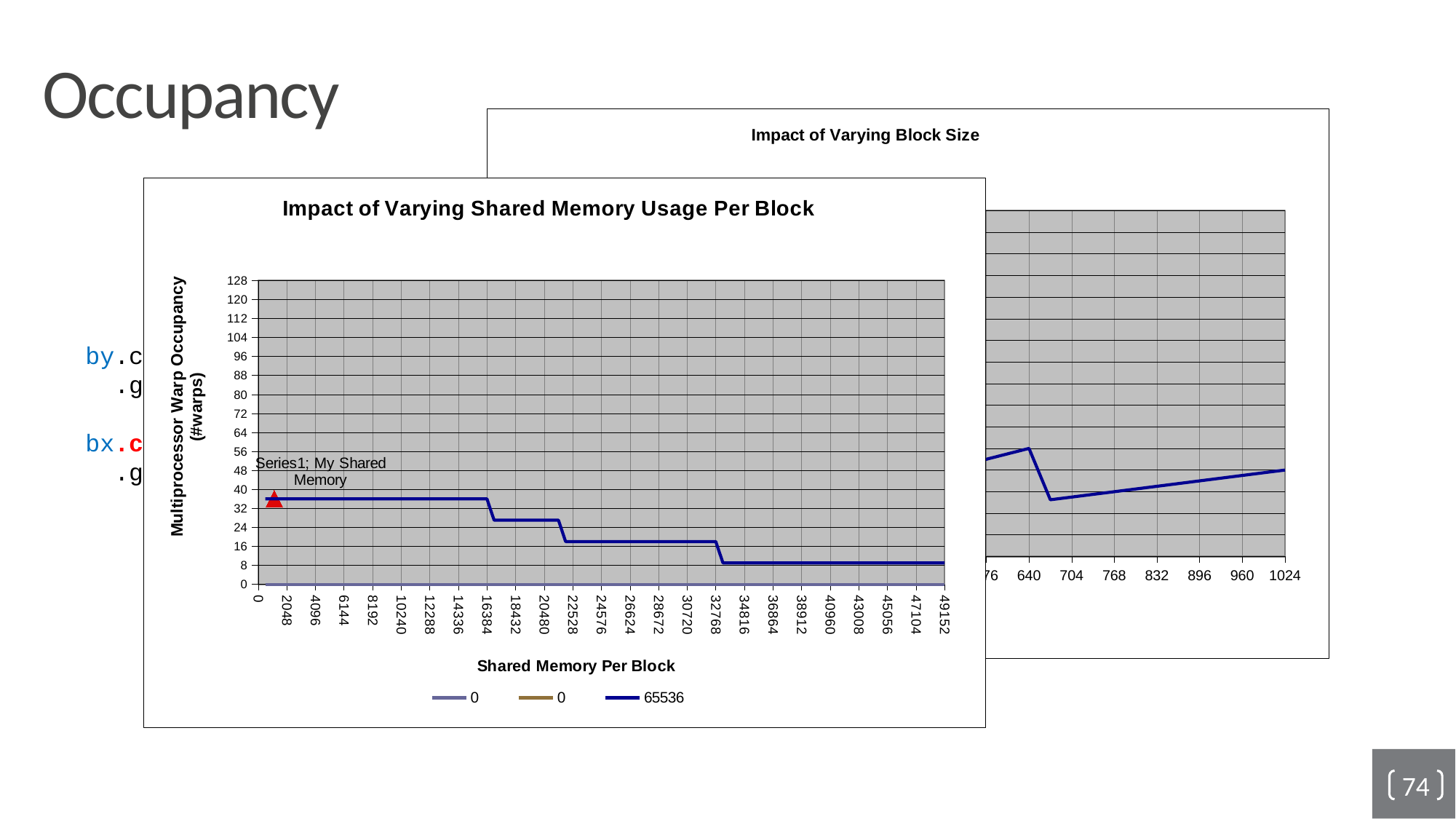
In the chart titled "Impact of Varying Shared Memory Usage Per Block", what kind of chart is shown? line chart In the chart titled "Impact of Varying Shared Memory Usage Per Block", is the value of the 65536 series at 8192 greater or less than 24? greater In the chart titled "Impact of Varying Shared Memory Usage Per Block", what is the label of the x axis? Shared Memory Per Block In the chart titled "Impact of Varying Shared Memory Usage Per Block", is the value of the 65536 series at 20480 greater or less than 32? less In the chart titled "Impact of Varying Shared Memory Usage Per Block", is the value of the 65536 series at 28672 greater or less than 24? less In the chart titled "Impact of Varying Shared Memory Usage Per Block", which is larger for the 65536 series: the value at 4096 or the value at 36864? the value at 4096 In the chart titled "Impact of Varying Shared Memory Usage Per Block", what is the highest value shown on the y axis? 128 In the chart titled "Impact of Varying Shared Memory Usage Per Block", how many series does the legend list? 3 In the chart titled "Impact of Varying Shared Memory Usage Per Block", do the values of the 65536 series rise or fall as shared memory per block increases? fall What is the title of the chart in front on the slide? Impact of Varying Shared Memory Usage Per Block In the chart titled "Impact of Varying Block Size", which is larger: the value at 640 or the value at 704? the value at 640